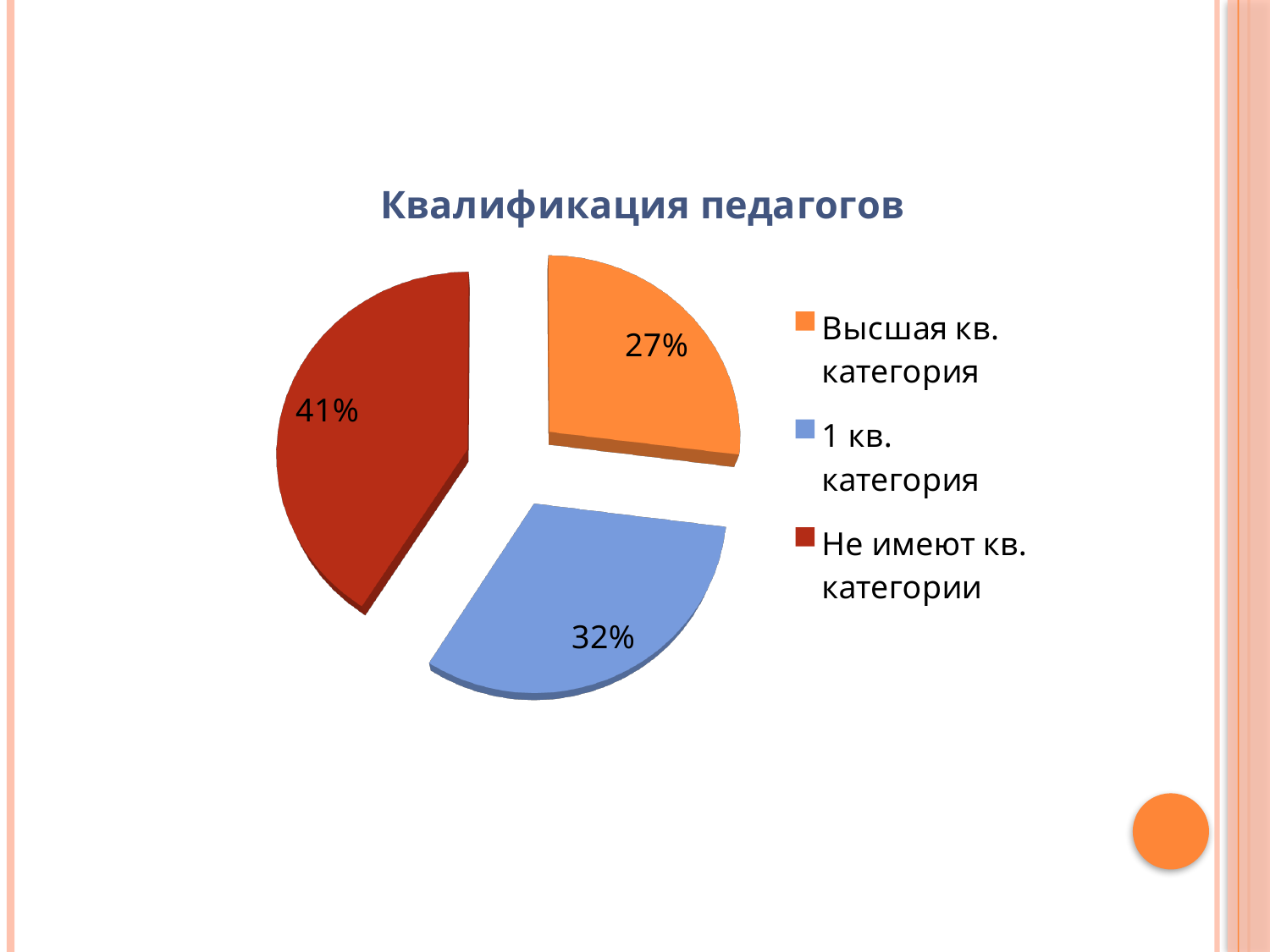
What colour is the slice for Не имеют кв. категории? Red What is the title of the chart? Квалификация педагогов What is the difference in percentage points between 1 кв. категория and Высшая кв. категория? 5 What share of the pie is labelled for Не имеют кв. категории? 41% Which is larger: the slice for 1 кв. категория or the slice for Высшая кв. категория? 1 кв. категория Which category has the largest slice of the pie? Не имеют кв. категории Which category has the smallest slice of the pie? Высшая кв. категория How many slices does the pie chart have? 3 What kind of chart is shown on the slide? Pie chart What share of the pie is labelled for 1 кв. категория? 32% What share of the pie is labelled for Высшая кв. категория? 27% What is the difference in percentage points between Не имеют кв. категории and Высшая кв. категория? 14